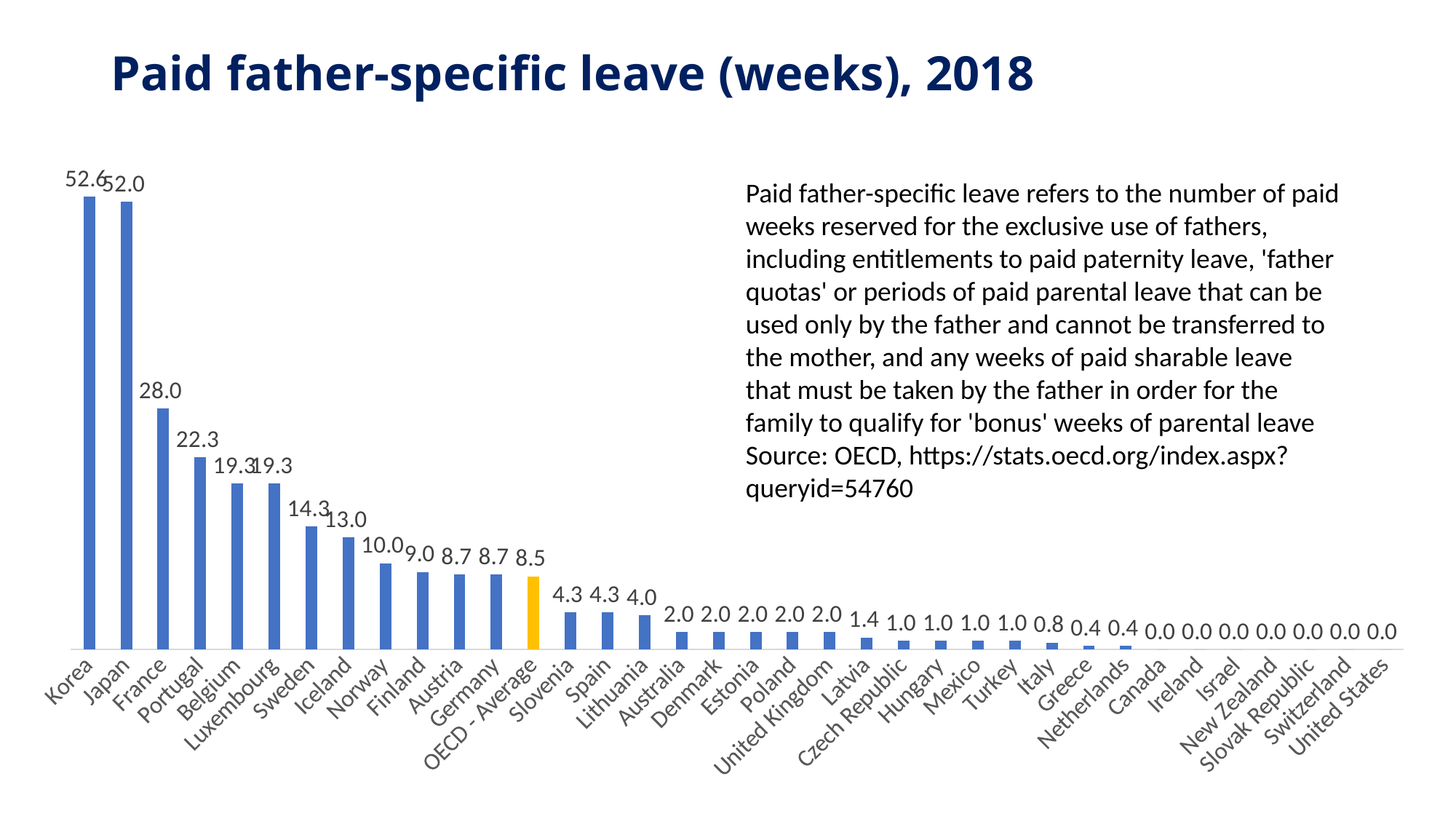
What kind of chart is this? Bar chart How many countries have a value of 0.0? 7 Which has a larger value, Sweden or Iceland? Sweden How many countries or categories are shown on the x axis? 36 Which country has the highest value? Korea What is the difference between the values for France and Portugal? 5.7 What is the difference between the values for Korea and Japan? 0.6 What is the value for France? 28.0 Which bar is coloured differently (orange) from the others? OECD - Average What is the value for the OECD - Average? 8.5 What is the value for Korea? 52.6 What is the value for Latvia? 1.4